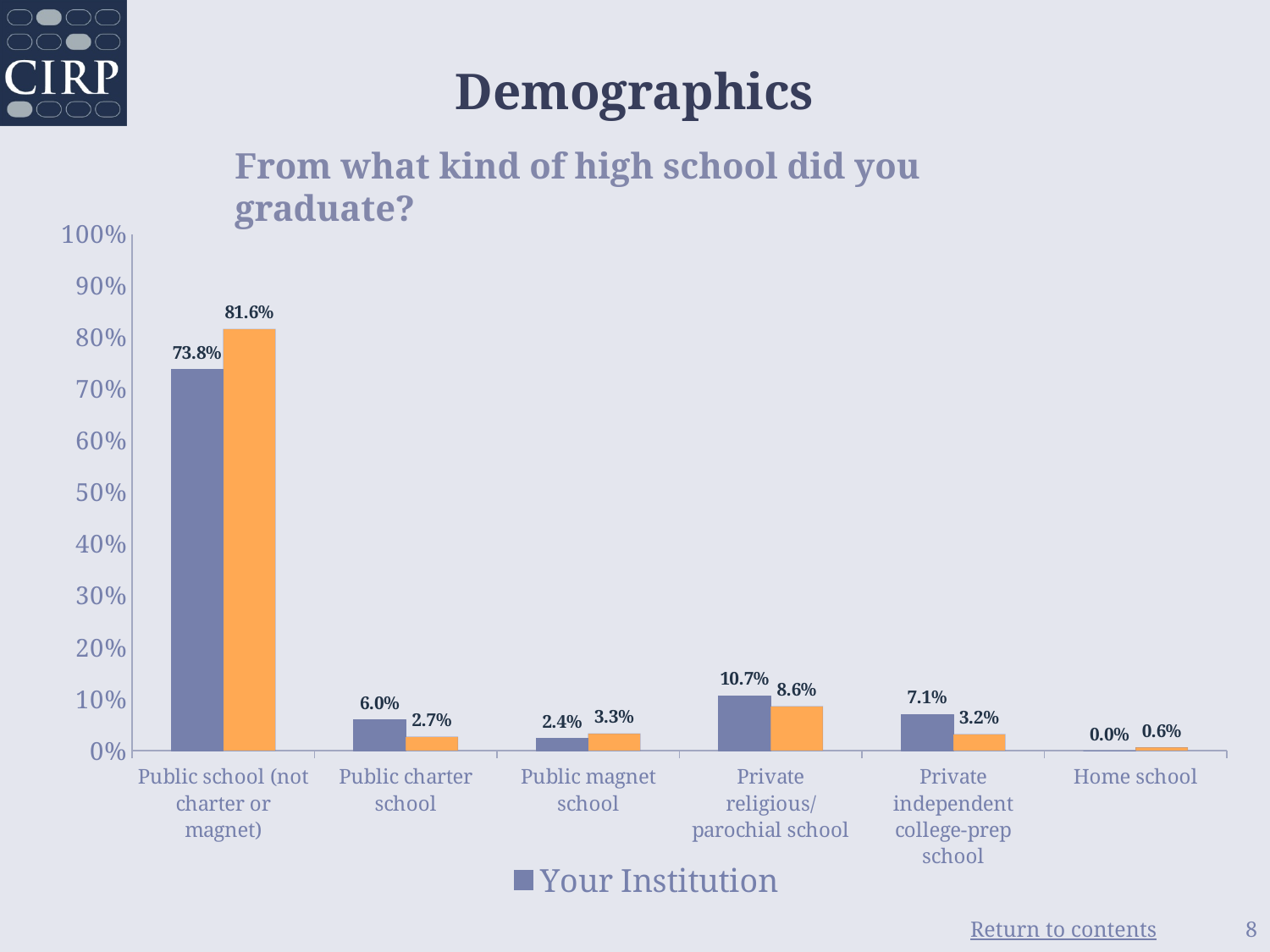
What is the value for Your Institution for Public school (not charter or magnet)? 73.8% What is the difference between the Your Institution values for Private religious/parochial school and Private independent college-prep school? 3.6% What is the value for Your Institution for Home school? 0.0% How many series does the legend list? 1 What kind of chart is shown on the slide? bar chart Which category has the highest value for Your Institution? Public school (not charter or magnet) Is the Your Institution value for Public school (not charter or magnet) greater or less than 70%? greater What is the value for Your Institution for Private religious/parochial school? 10.7% How many categories are shown on the x axis? 6 Which category has the lowest value for Your Institution? Home school For Your Institution, which is larger: Public charter school or Public magnet school? Public charter school What is the value for Your Institution for Public charter school? 6.0%